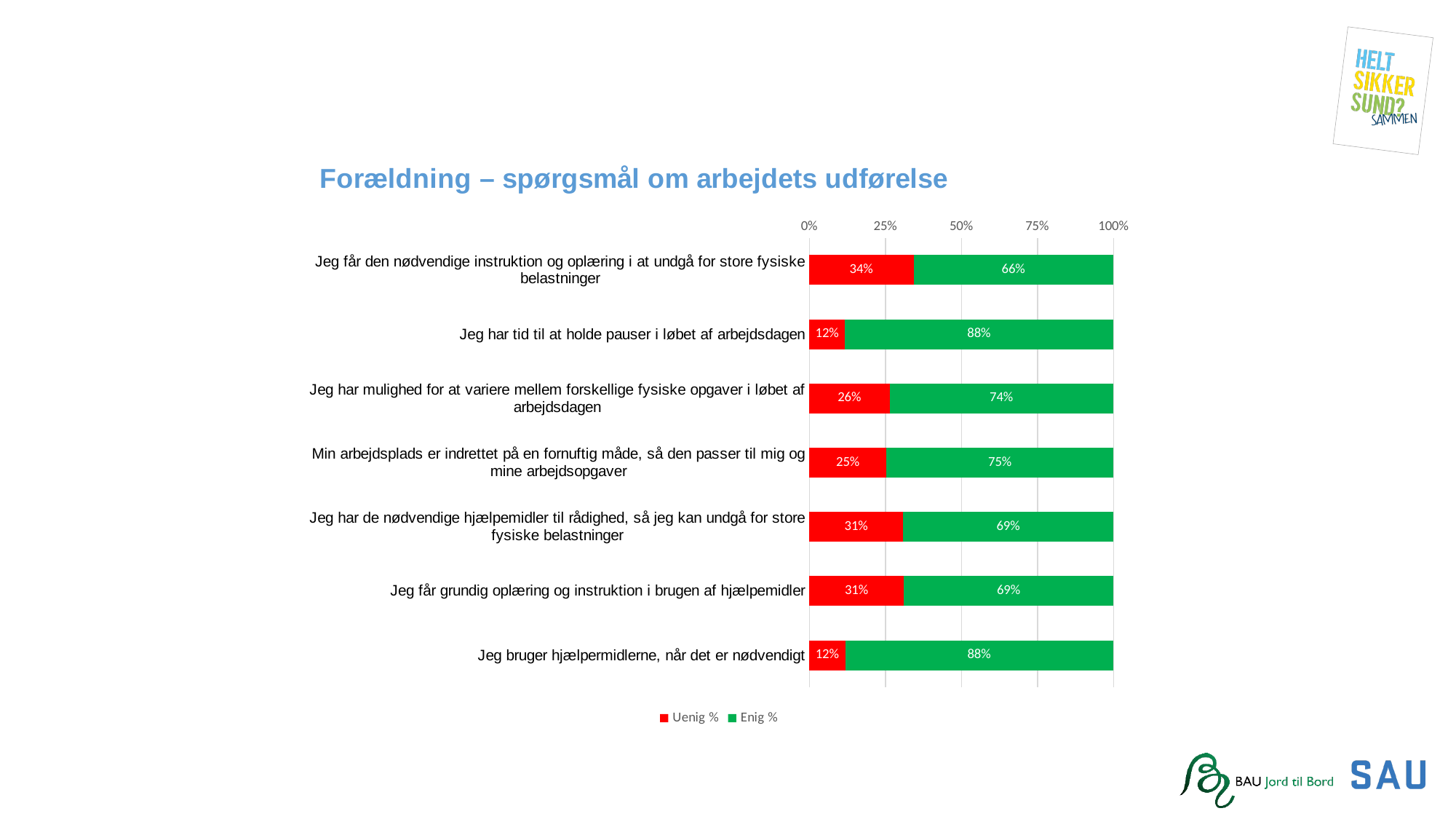
Is the Uenig % value for "Jeg har de nødvendige hjælpemidler til rådighed, så jeg kan undgå for store fysiske belastninger" greater or less than 25%? greater How many statements (categories) are shown in the chart? 7 Which statement has the highest Uenig % value? Jeg får den nødvendige instruktion og oplæring i at undgå for store fysiske belastninger What kind of chart is shown on the slide? Stacked bar chart What is the Uenig % value for "Jeg får den nødvendige instruktion og oplæring i at undgå for store fysiske belastninger"? 34% What is the difference between the Enig % and Uenig % values for "Jeg har mulighed for at variere mellem forskellige fysiske opgaver i løbet af arbejdsdagen"? 48% What is the Enig % value for "Min arbejdsplads er indrettet på en fornuftig måde, så den passer til mig og mine arbejdsopgaver"? 75% Which is larger: the Enig % for "Jeg bruger hjælpermidlerne, når det er nødvendigt" or the Enig % for "Jeg får grundig oplæring og instruktion i brugen af hjælpemidler"? Jeg bruger hjælpermidlerne, når det er nødvendigt What is the Enig % value for "Jeg har tid til at holde pauser i løbet af arbejdsdagen"? 88% How many series does the legend list? 2 Which statement has the lowest Enig % value? Jeg får den nødvendige instruktion og oplæring i at undgå for store fysiske belastninger What is the total of the stacked bar for "Jeg får grundig oplæring og instruktion i brugen af hjælpemidler"? 100%